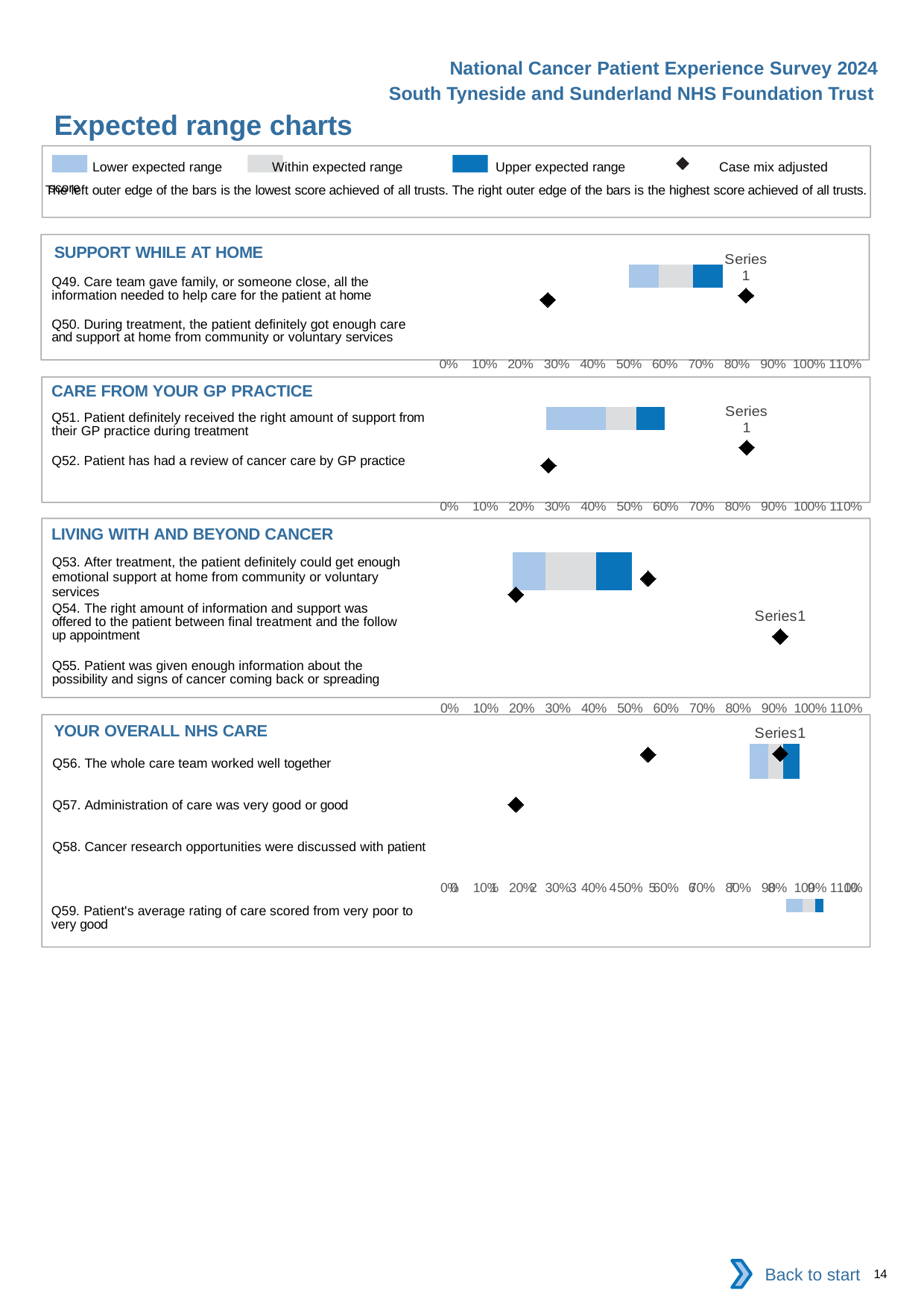
How many questions are listed in the YOUR OVERALL NHS CARE section? 4 In the LIVING WITH AND BEYOND CANCER chart, is the left outer edge of the bar greater or less than 30%? less What is the highest tick label shown on the x axis of the CARE FROM YOUR GP PRACTICE chart? 110% According to the legend, which symbol represents the case mix adjusted score? a diamond How many entries does the legend at the top of the slide list? 4 In the CARE FROM YOUR GP PRACTICE chart, is the left outer edge of the bar greater or less than 50%? less In the LIVING WITH AND BEYOND CANCER chart, is the right outer edge of the bar greater or less than 40%? greater How many questions are listed in the LIVING WITH AND BEYOND CANCER section? 3 How many questions are listed in the SUPPORT WHILE AT HOME section? 2 According to the legend, which colour represents the upper expected range? dark blue What kind of chart is used in the SUPPORT WHILE AT HOME section? bar chart